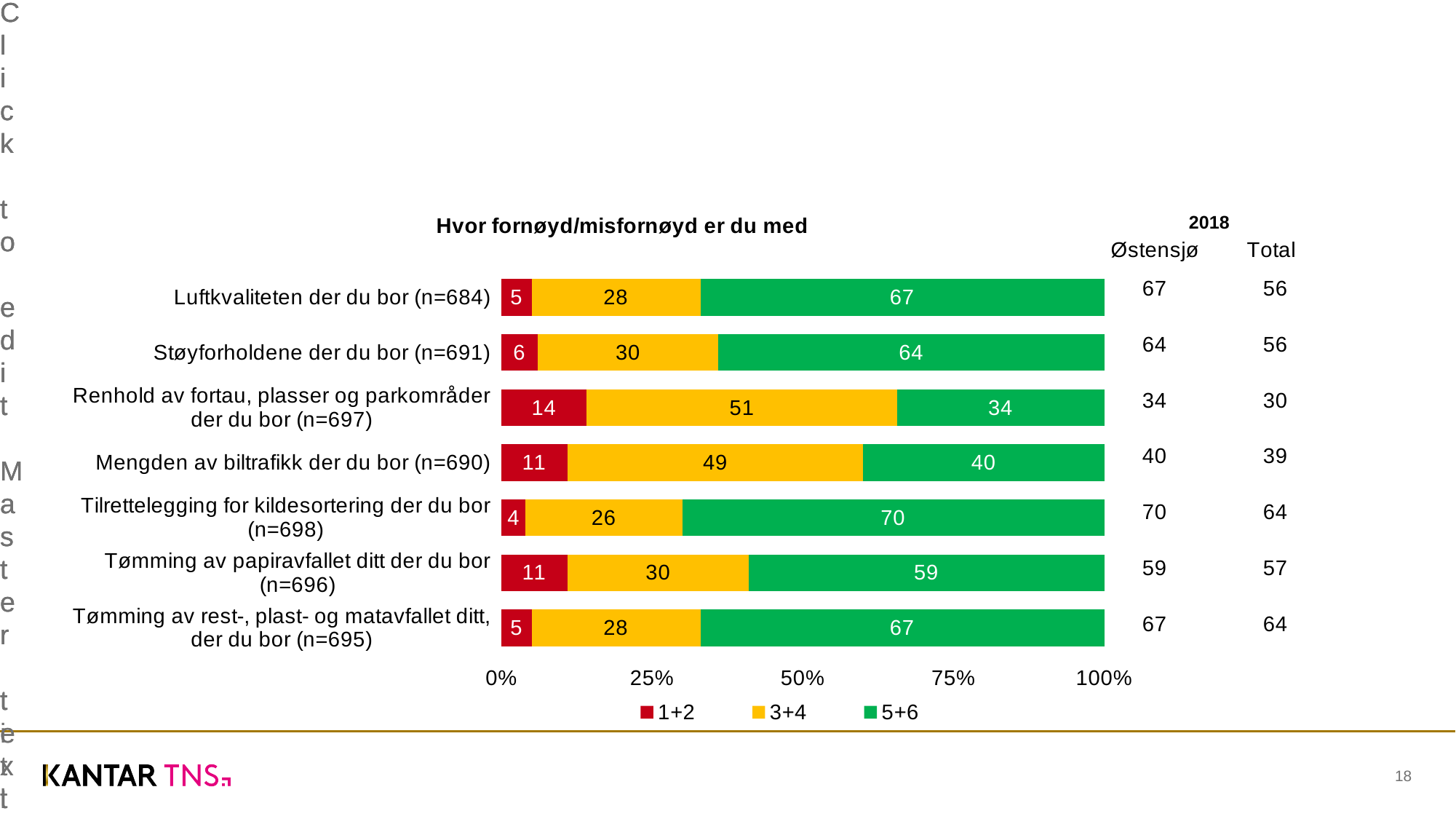
How many series does the legend list? 3 What is the value of the 5+6 series for "Luftkvaliteten der du bor (n=684)"? 67 What is the total of the stacked bar for "Mengden av biltrafikk der du bor (n=690)"? 100 How many categories are shown in the chart? 7 Which is larger: the 3+4 value for "Støyforholdene der du bor (n=691)" or the 3+4 value for "Renhold av fortau, plasser og parkområder der du bor (n=697)"? Renhold av fortau, plasser og parkområder der du bor (n=697) What is the difference between the 5+6 values for "Tilrettelegging for kildesortering der du bor (n=698)" and "Tømming av papiravfallet ditt der du bor (n=696)"? 11 What is the value of the 3+4 series for "Mengden av biltrafikk der du bor (n=690)"? 49 What is the title of the chart? Hvor fornøyd/misfornøyd er du med Which category has the lowest value in the 5+6 series? Renhold av fortau, plasser og parkområder der du bor (n=697) What is the value of the 1+2 series for "Renhold av fortau, plasser og parkområder der du bor (n=697)"? 14 Which category has the highest value in the 5+6 series? Tilrettelegging for kildesortering der du bor (n=698) What kind of chart is shown on the slide? Stacked bar chart